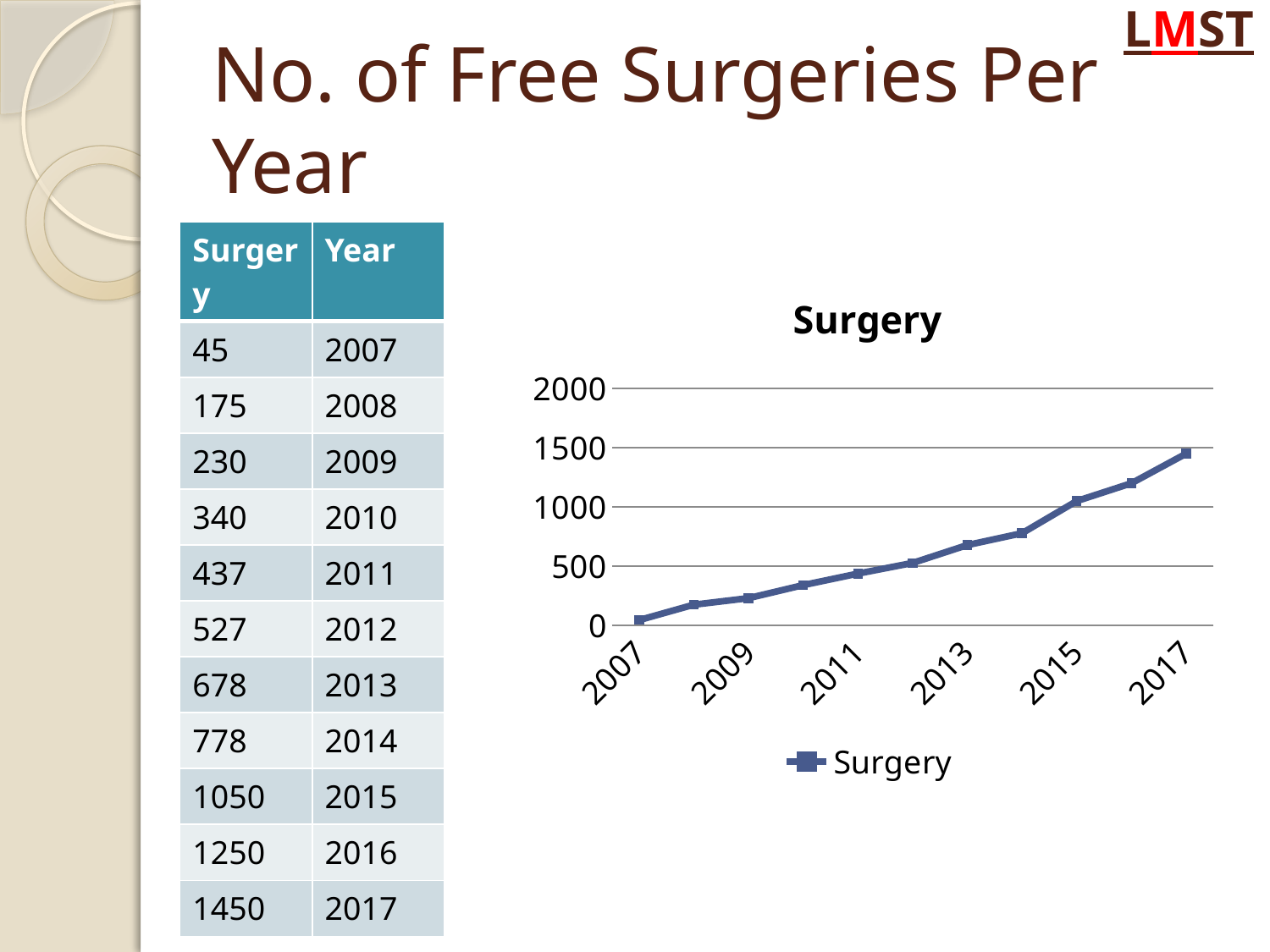
What is the difference between the number of surgeries in 2017 and in 2007? 1405 How many data points are plotted on the Surgery line? 11 Which year has the larger value, 2010 or 2014? 2014 Which year has the highest number of surgeries on the chart? 2017 Which year has the lowest number of surgeries on the chart? 2007 How many series does the chart legend list? 1 What is the number of surgeries for 2017? 1450 Is the value for 2015 greater or less than 1000? greater What kind of chart is shown on the slide? line chart Do the values on the Surgery chart rise or fall from 2007 to 2017? rise What is the title of the chart? Surgery Is the value for 2012 greater or less than 1000? less